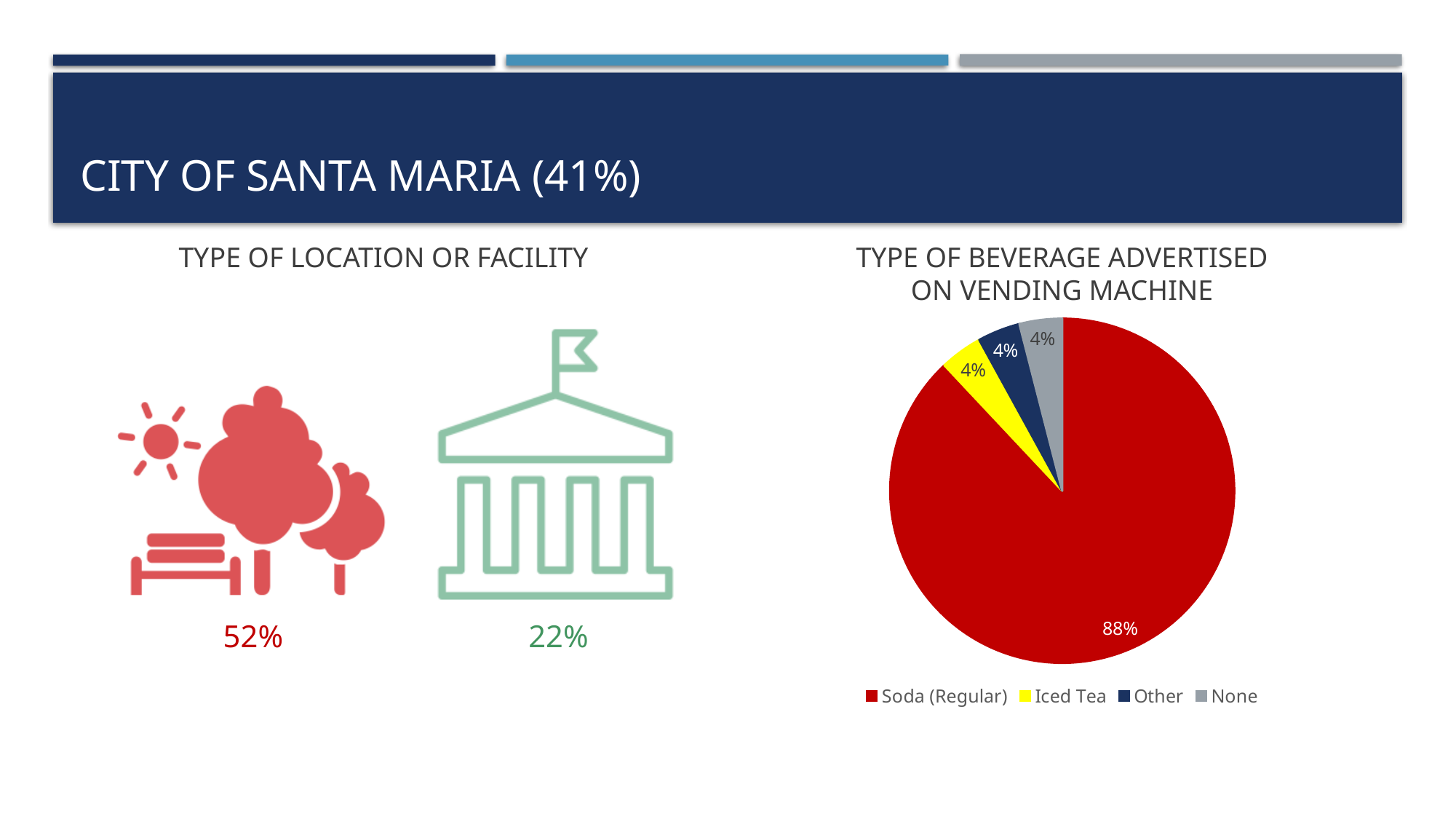
In the pie chart titled 'Type of Beverage Advertised on Vending Machine', how many percentage points larger is Soda (Regular) than Iced Tea? 84 In the pie chart titled 'Type of Beverage Advertised on Vending Machine', what share is labelled None? 4% In the pie chart titled 'Type of Beverage Advertised on Vending Machine', what share is Iced Tea? 4% In the pie chart titled 'Type of Beverage Advertised on Vending Machine', what colour is the Iced Tea slice? Yellow In the pie chart titled 'Type of Beverage Advertised on Vending Machine', which category is shown in red? Soda (Regular) In the pie chart titled 'Type of Beverage Advertised on Vending Machine', how many categories does the legend list? 4 What kind of chart is the chart titled 'Type of Beverage Advertised on Vending Machine'? Pie chart In the pie chart titled 'Type of Beverage Advertised on Vending Machine', what share is labelled Other? 4% In the pie chart titled 'Type of Beverage Advertised on Vending Machine', which category has the largest slice? Soda (Regular) In the pie chart titled 'Type of Beverage Advertised on Vending Machine', what is the combined share of Iced Tea, Other and None? 12% In the pie chart titled 'Type of Beverage Advertised on Vending Machine', what share is Soda (Regular)? 88% In the pie chart titled 'Type of Beverage Advertised on Vending Machine', which is larger, Soda (Regular) or None? Soda (Regular)